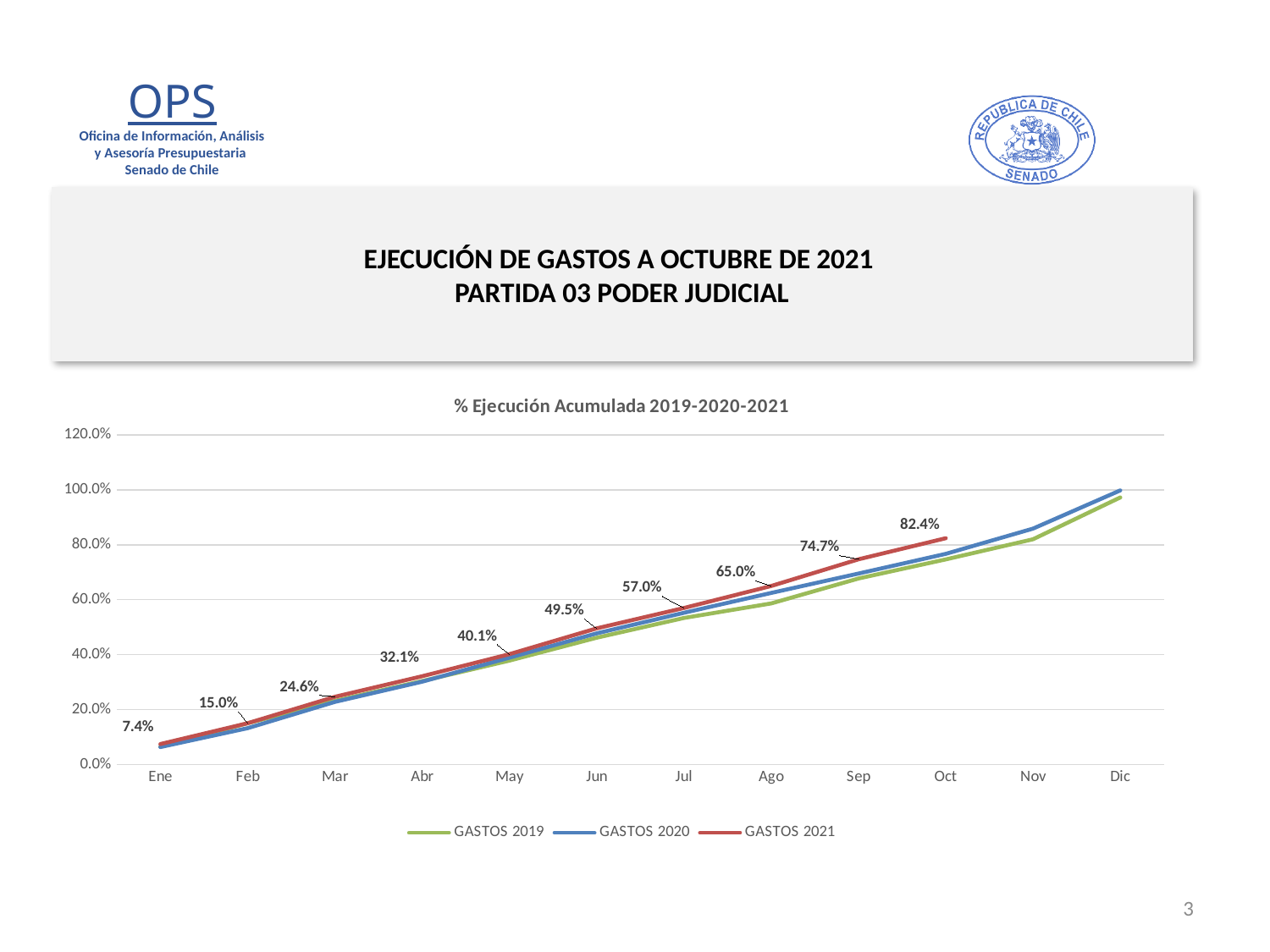
How many series does the legend list? 3 What type of chart is shown on the slide? Line chart Which is larger for GASTOS 2021, the value in Jul or the value in Jun? Jul What is the value for GASTOS 2021 in May? 40.1% Is the value for GASTOS 2020 in Sep greater or less than 60.0%? greater What is the value for GASTOS 2021 in Oct? 82.4% What is the title of the chart? % Ejecución Acumulada 2019-2020-2021 What is the value for GASTOS 2021 in Ene? 7.4% How many months are shown on the x axis? 12 Which month has the lowest labelled value for GASTOS 2021? Ene What is the difference between the GASTOS 2021 values for Oct and Sep? 7.7 percentage points Do the values for GASTOS 2021 rise or fall from Ene to Oct? Rise